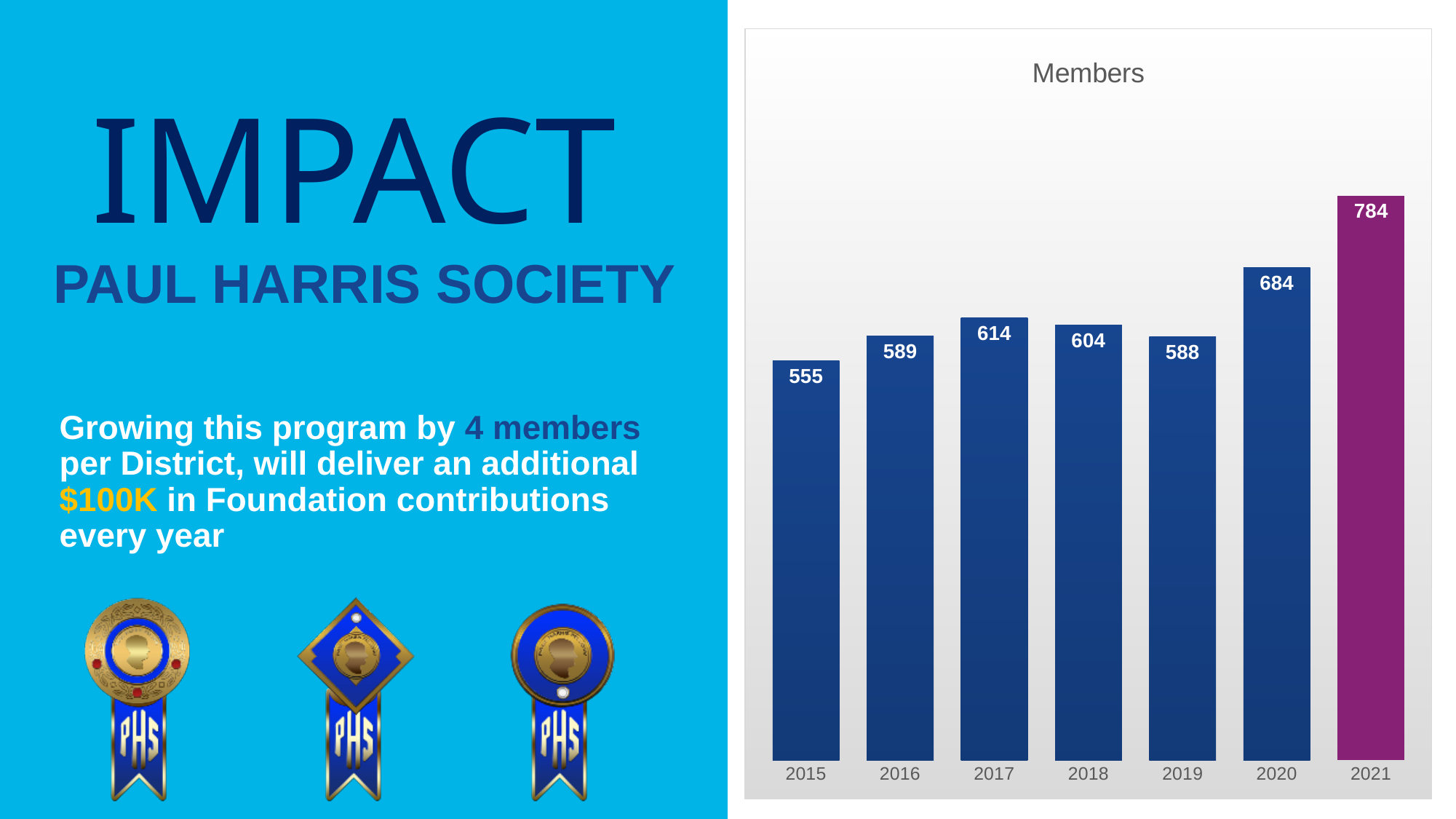
What is the difference in members between 2017 and 2016? 25 What is the title of the chart on the slide? Members What is the difference in members between 2021 and 2020? 100 Which year has the lowest number of members? 2015 Which year has the highest number of members? 2021 What is the value for 2015 in the Members chart? 555 What kind of chart is the Members chart? bar chart What is the value for 2021 in the Members chart? 784 What is the value for 2019 in the Members chart? 588 How many years are shown in the Members chart? 7 Which year has more members, 2018 or 2019? 2018 Do the member values rise or fall from 2019 to 2021? rise